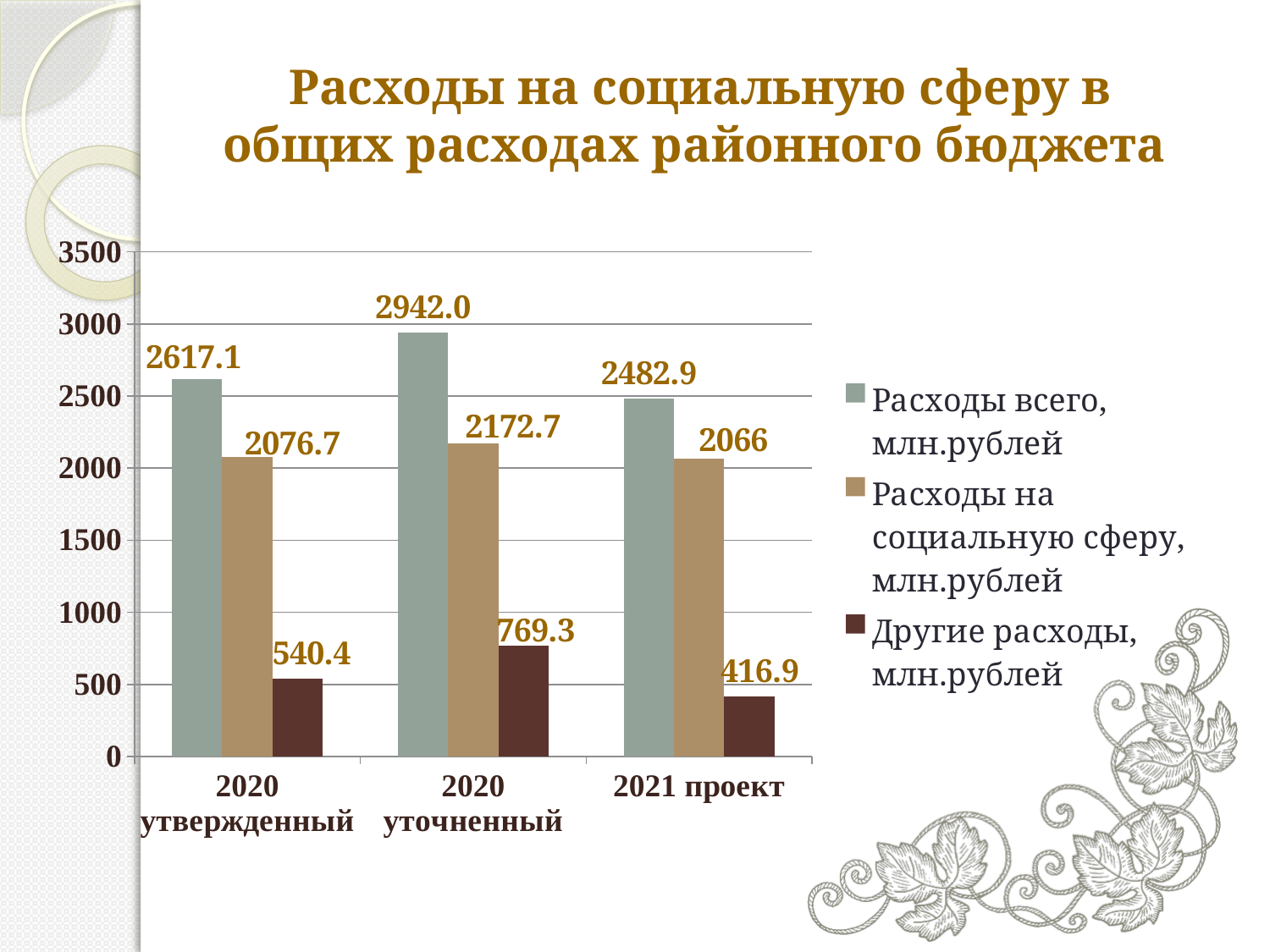
Which is larger: "Другие расходы, млн.рублей" for "2020 уточненный" or for "2021 проект"? 2020 уточненный Which category has the highest value for "Расходы всего, млн.рублей"? 2020 уточненный What is the value of "Расходы на социальную сферу, млн.рублей" for "2021 проект"? 2066 How many series does the legend list? 3 What is the title of the slide? Расходы на социальную сферу в общих расходах районного бюджета What is the difference between "Расходы всего, млн.рублей" and "Расходы на социальную сферу, млн.рублей" for "2020 утвержденный"? 540.4 What kind of chart is shown on the slide? bar chart What is the value of "Расходы всего, млн.рублей" for "2020 уточненный"? 2942.0 Is the value of "Расходы на социальную сферу, млн.рублей" for "2020 уточненный" greater or less than 2000? greater How many categories are shown on the x axis? 3 What is the value of "Другие расходы, млн.рублей" for "2020 утвержденный"? 540.4 Which category has the lowest value for "Другие расходы, млн.рублей"? 2021 проект